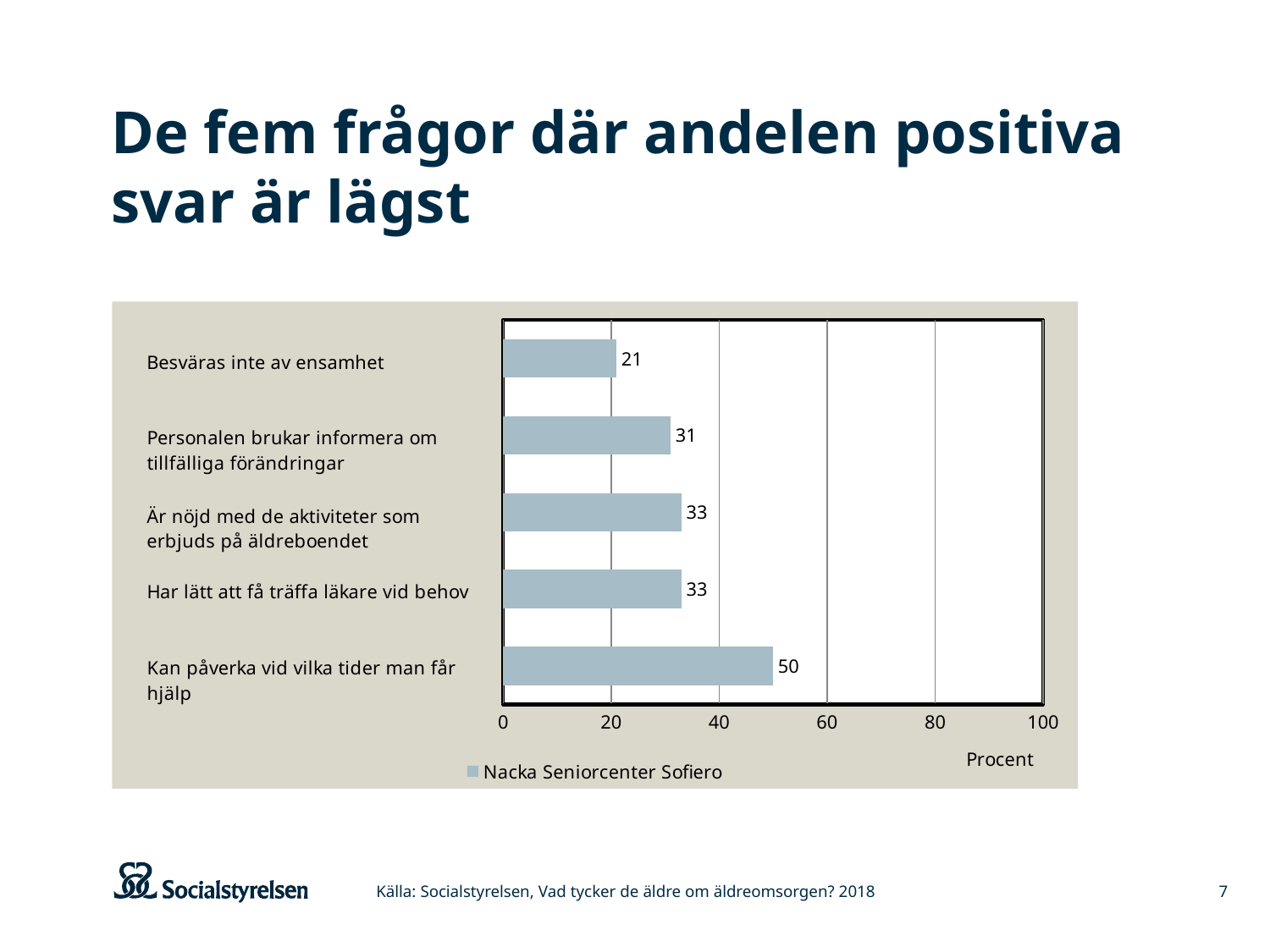
What is the value for "Personalen brukar informera om tillfälliga förändringar"? 31 How many categories are shown in the chart? 5 What is the value for "Besväras inte av ensamhet"? 21 How many series does the legend list? 1 What is the difference between the values for "Kan påverka vid vilka tider man får hjälp" and "Besväras inte av ensamhet"? 29 What is the value for "Kan påverka vid vilka tider man får hjälp"? 50 What series name is shown in the legend? Nacka Seniorcenter Sofiero Which category has the highest value? Kan påverka vid vilka tider man får hjälp Which category has the lowest value? Besväras inte av ensamhet Which is larger, the value for "Personalen brukar informera om tillfälliga förändringar" or the value for "Besväras inte av ensamhet"? Personalen brukar informera om tillfälliga förändringar What kind of chart is shown on the slide? bar chart Is the value for "Har lätt att få träffa läkare vid behov" greater or less than 40? less